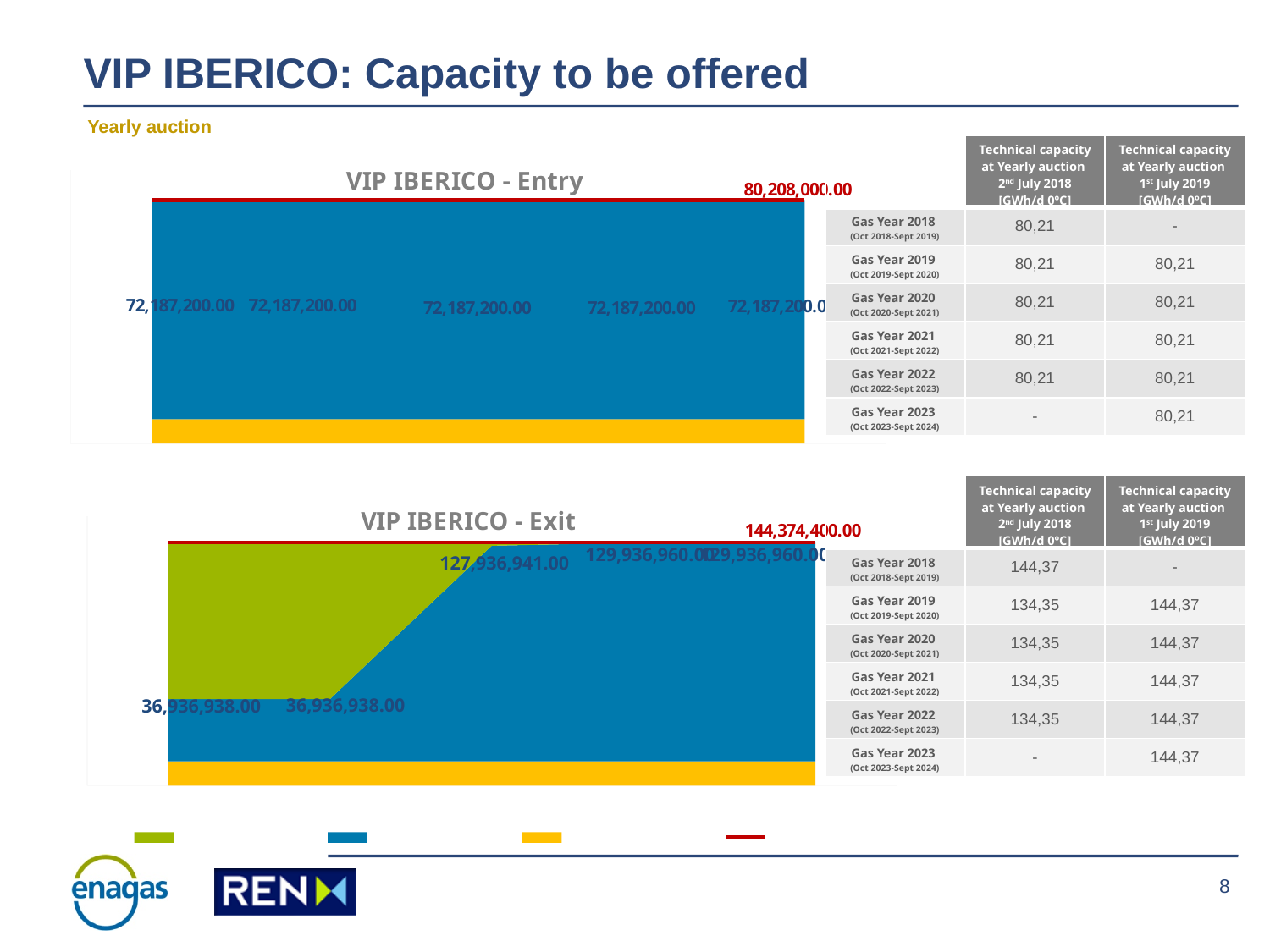
In the VIP IBERICO - Entry chart, how many times is the value 72,187,200.00 labelled? 5 In the VIP IBERICO - Exit chart, what is the difference between the red line value 144,374,400.00 and the labelled value 129,936,960.00? 14,437,440.00 In the VIP IBERICO - Exit chart, does the green area grow or shrink from left to right? shrinks What kind of chart is the VIP IBERICO - Exit chart? combination area and line chart In the VIP IBERICO - Exit chart, which is larger: 127,936,941.00 or 129,936,960.00? 129,936,960.00 In the VIP IBERICO - Entry chart, what value is repeated across the blue area? 72,187,200.00 In the VIP IBERICO - Exit chart, what value is labelled on the red line at the top? 144,374,400.00 In the VIP IBERICO - Entry chart, what is the difference between the red line value 80,208,000.00 and the blue area value 72,187,200.00? 8,020,800.00 In the VIP IBERICO - Entry chart, does the blue area rise, fall or stay flat from left to right? stays flat In the VIP IBERICO - Entry chart, what value is labelled on the red line at the top? 80,208,000.00 In the VIP IBERICO - Exit chart, what is the lowest value labelled? 36,936,938.00 What is the title of the top chart on the slide? VIP IBERICO - Entry